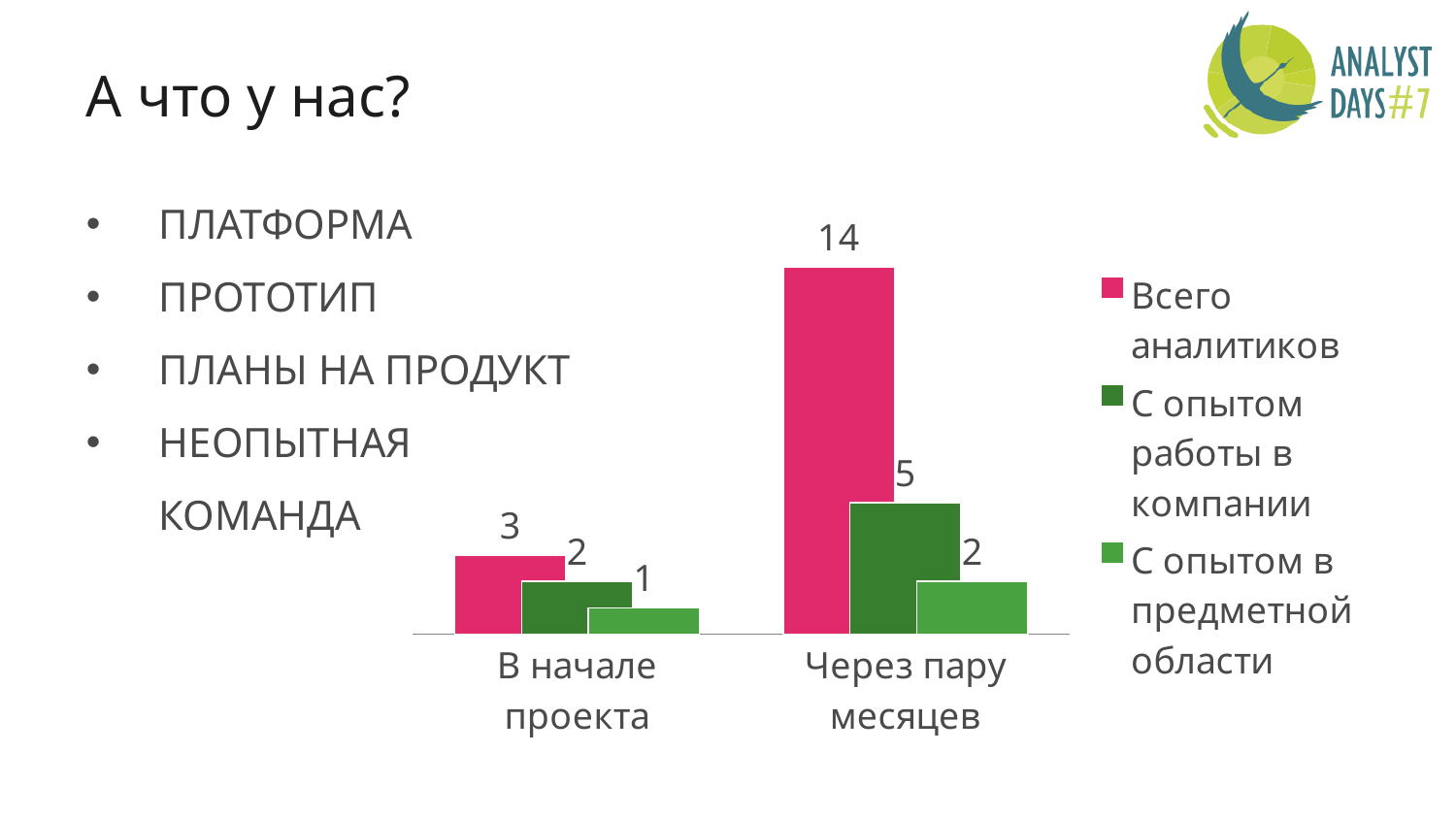
What kind of chart is shown on the slide? Bar chart How many series does the legend list? 3 Which is larger: "С опытом работы в компании" in "Через пару месяцев" or "Всего аналитиков" in "В начале проекта"? С опытом работы в компании in Через пару месяцев How many categories are shown on the x axis of the chart? 2 What is the value for "Всего аналитиков" in the "Через пару месяцев" category? 14 Which series has the highest value in the "Через пару месяцев" category? Всего аналитиков Does the value for "Всего аналитиков" rise or fall from "В начале проекта" to "Через пару месяцев"? Rise What is the difference between "Всего аналитиков" in "Через пару месяцев" and in "В начале проекта"? 11 What is the value for "Всего аналитиков" in the "В начале проекта" category? 3 What is the value for "С опытом в предметной области" in the "Через пару месяцев" category? 2 Which series has the lowest value in the "В начале проекта" category? С опытом в предметной области What is the value for "С опытом работы в компании" in the "В начале проекта" category? 2